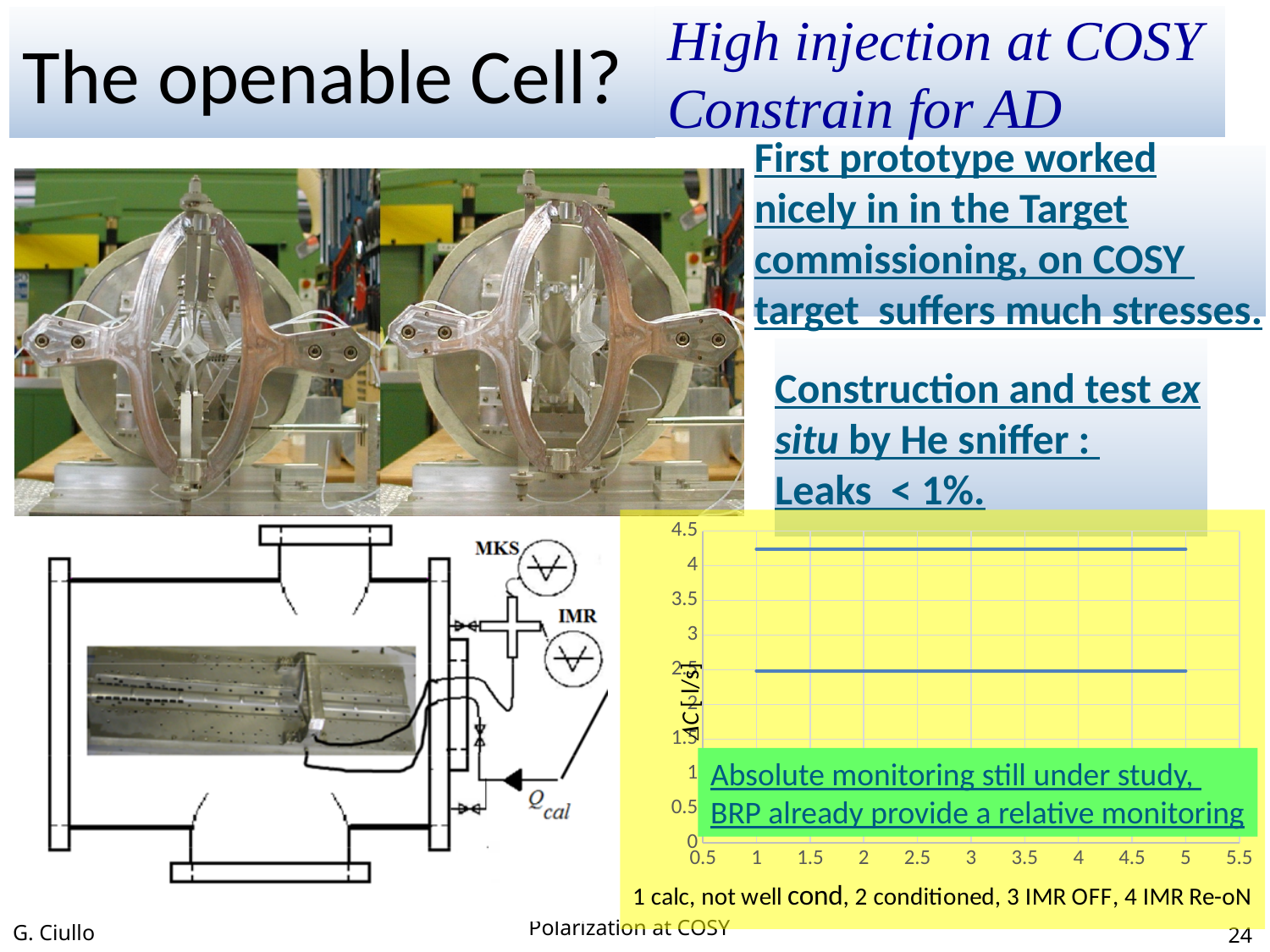
Do the plotted lines rise, fall, or stay flat along the x axis? stay flat What kind of chart is shown on the slide? line chart Is the value of the lower line on the chart greater or less than 3? less How many lines are plotted on the chart? 2 Is the value of the upper line on the chart greater or less than 4? greater What is the lowest tick value shown on the x axis of the chart? 0.5 Is the value of the lower line on the chart greater or less than 2? greater What is the highest tick value shown on the y axis of the chart? 4.5